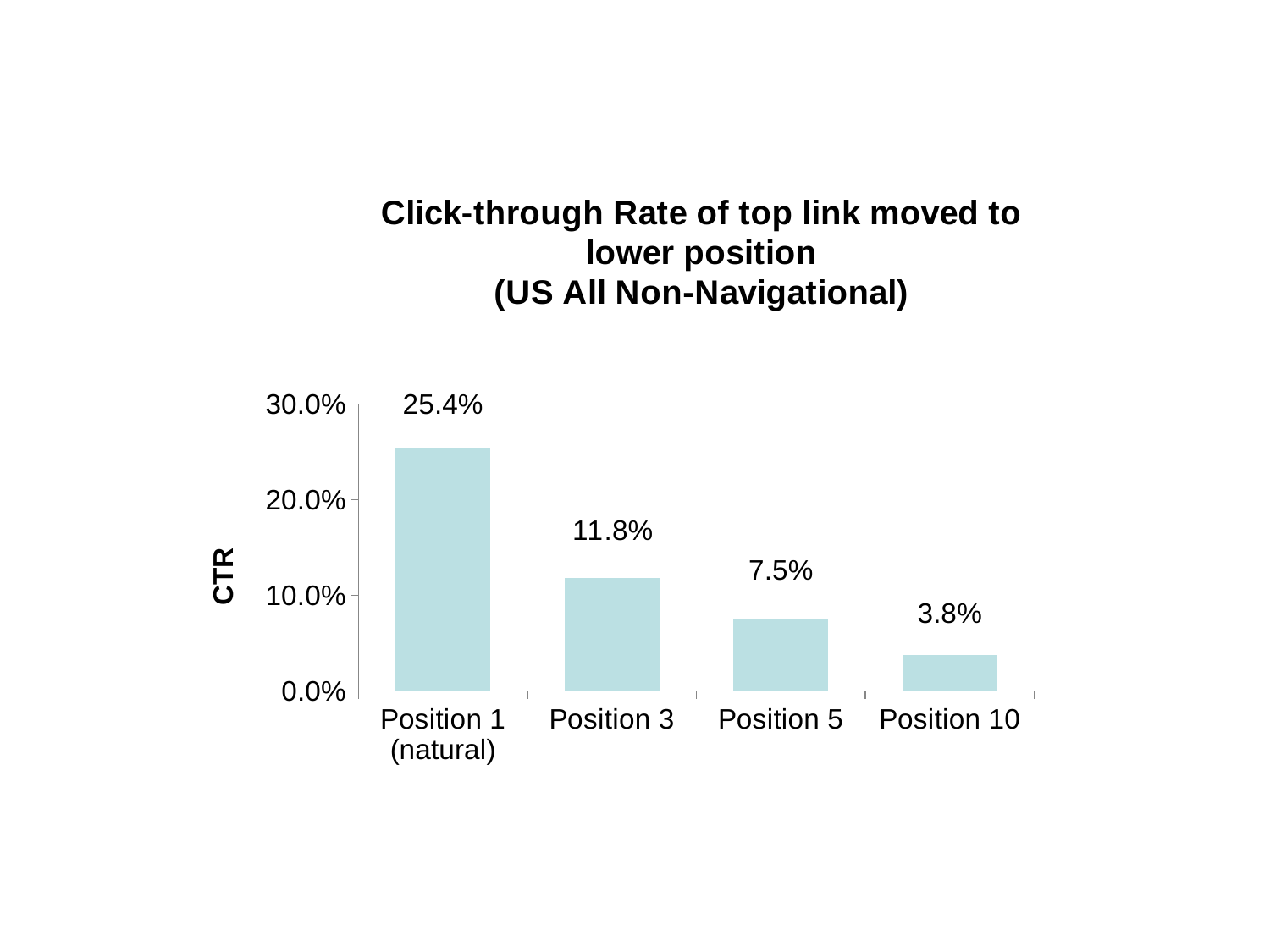
Which position has the lowest CTR? Position 10 What is the CTR for Position 5? 7.5% Which has a higher CTR, Position 3 or Position 5? Position 3 What is the CTR for Position 1 (natural)? 25.4% How many positions are shown on the chart? 4 Which position has the highest CTR? Position 1 (natural) Do the CTR values rise or fall from Position 1 (natural) to Position 10? Fall What is the CTR for Position 10? 3.8% What is the difference in CTR between Position 5 and Position 10? 3.7% What kind of chart is shown on the slide? Bar chart What is the difference in CTR between Position 1 (natural) and Position 3? 13.6% What is the CTR for Position 3? 11.8%